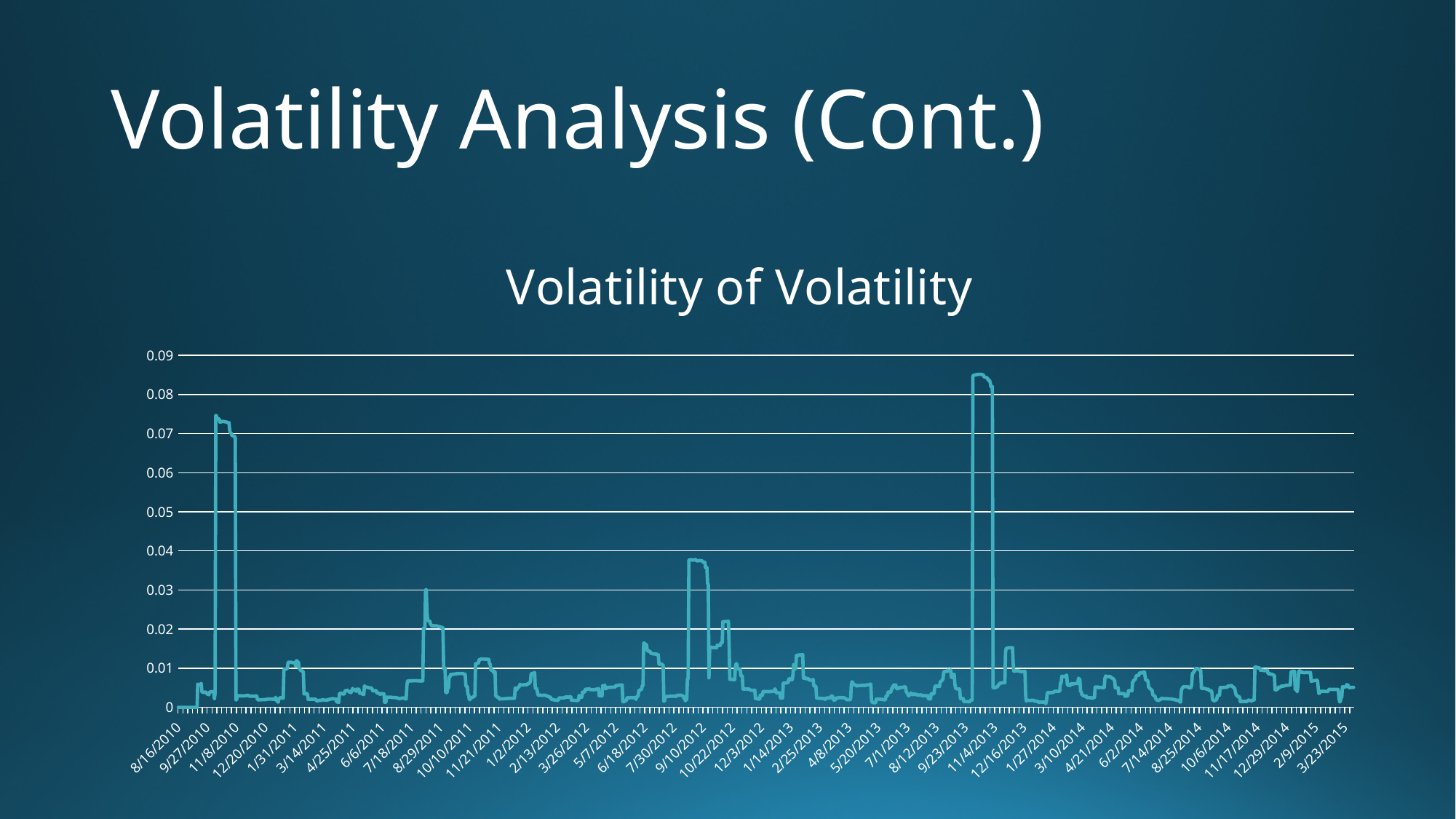
In which period does the line reach its highest value? between 9/23/2013 and 11/4/2013 What is the highest value labelled on the vertical axis? 0.09 Is the peak of the line between 9/27/2010 and 11/8/2010 greater or less than 0.07? greater How many data series are plotted in the chart? 1 Is the peak of the line near 9/10/2012 greater or less than 0.03? greater Is the highest peak of the line, between 9/23/2013 and 11/4/2013, greater or less than 0.08? greater What is the title of the chart? Volatility of Volatility What kind of chart is shown on the slide? line chart Which is larger: the peak between 9/23/2013 and 11/4/2013 or the peak between 9/27/2010 and 11/8/2010? the peak between 9/23/2013 and 11/4/2013